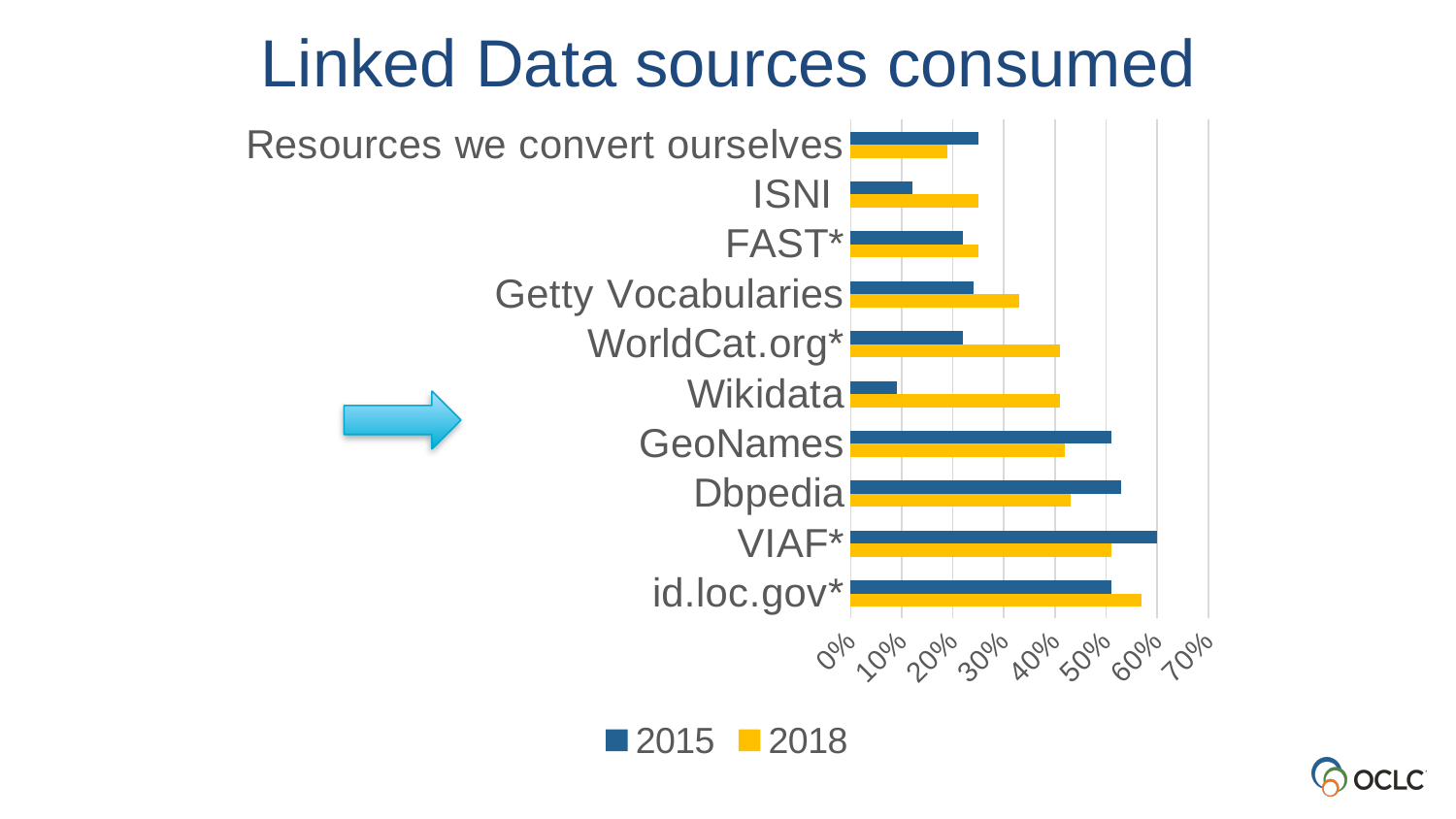
How many Linked Data sources (categories) are plotted on the chart? 10 Is the 2015 value for VIAF* greater or less than 50%? greater For Wikidata, which year has the larger value, 2015 or 2018? 2018 What is the title of the chart? Linked Data sources consumed Is the 2015 value for Wikidata greater or less than 20%? less What kind of chart is shown on the slide? bar chart How many series does the legend list? 2 Which source has the lowest value for 2015? Wikidata Which source has the highest value for 2018? id.loc.gov* Which colour represents the 2018 series in the legend? yellow Which source has the highest value for 2015? VIAF* For VIAF*, which year has the larger value, 2015 or 2018? 2015